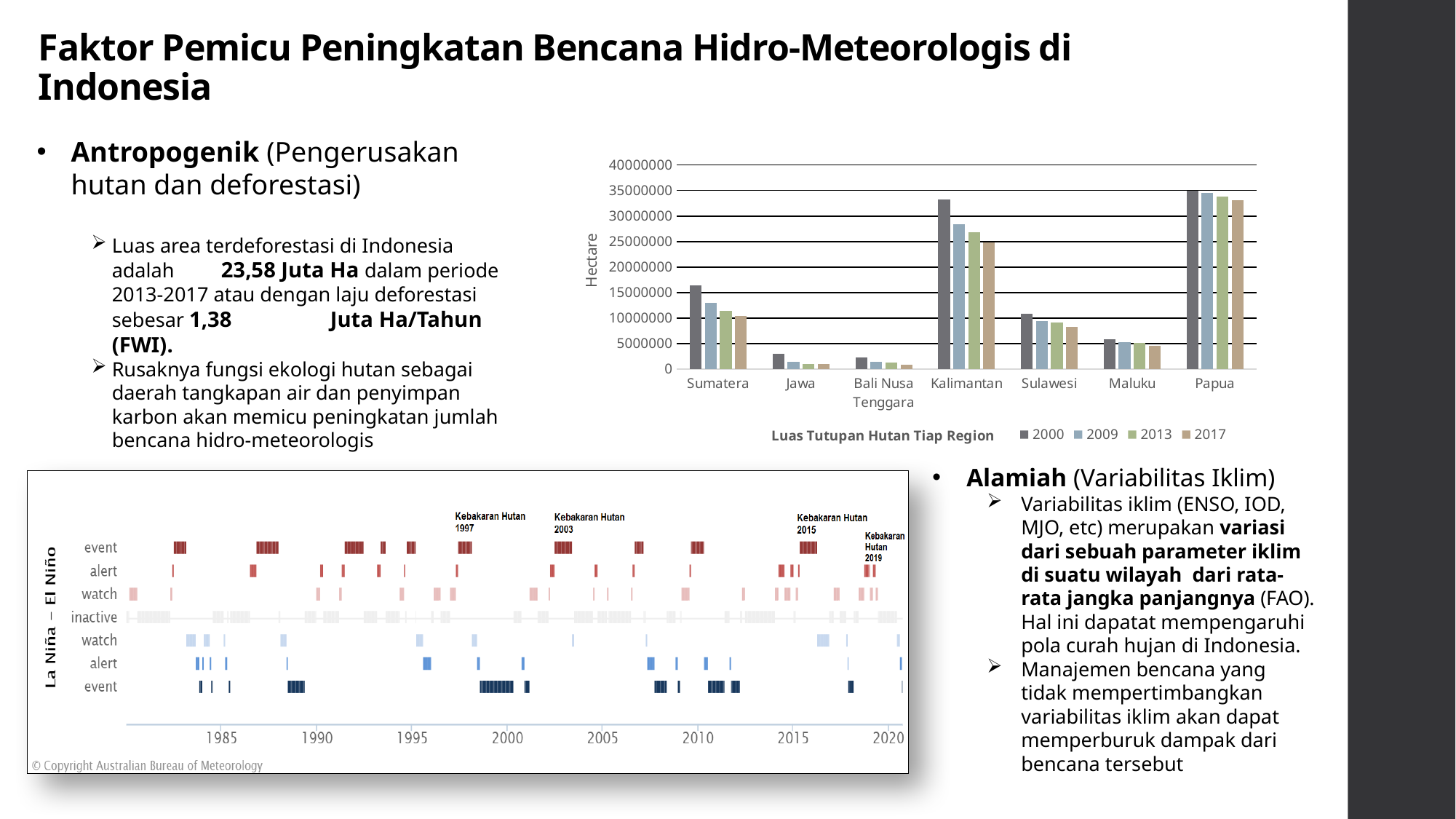
In the 'Luas Tutupan Hutan Tiap Region' chart, which region has the highest value for 2000? Papua In the 'Luas Tutupan Hutan Tiap Region' chart, which is larger for 2000: Kalimantan or Sulawesi? Kalimantan How many regions are shown on the x axis of the 'Luas Tutupan Hutan Tiap Region' chart? 7 In the 'Luas Tutupan Hutan Tiap Region' chart, is the 2000 value for Maluku greater or less than 10000000? less In the 'Luas Tutupan Hutan Tiap Region' chart, is the 2000 value for Kalimantan greater or less than 30000000? greater How many series does the legend of the 'Luas Tutupan Hutan Tiap Region' chart list? 4 What kind of chart is the 'Luas Tutupan Hutan Tiap Region' chart? bar chart In the 'Luas Tutupan Hutan Tiap Region' chart, do the values for Sumatera rise or fall from 2000 to 2017? fall In the 'Luas Tutupan Hutan Tiap Region' chart, is the 2000 value for Sumatera greater or less than 15000000? greater What is the y-axis label of the 'Luas Tutupan Hutan Tiap Region' chart? Hectare Which years are listed in the legend of the bar chart on the slide? 2000, 2009, 2013, 2017